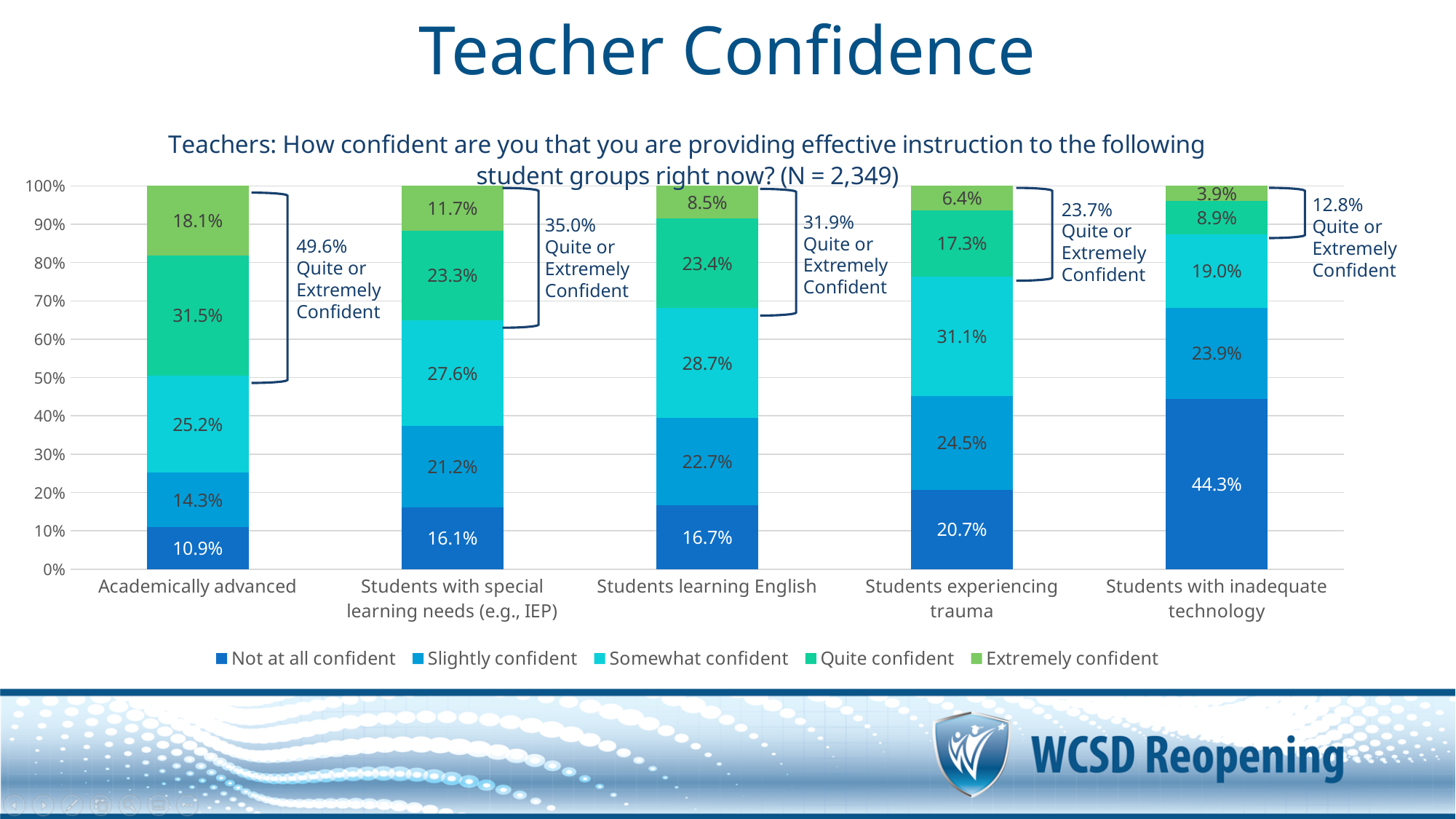
How many series does the legend list? 5 Which student group has the highest 'Not at all confident' percentage? Students with inadequate technology How many student groups are shown on the x axis? 5 What is the difference between the 'Not at all confident' percentages for students with inadequate technology and academically advanced students? 33.4% What percentage of teachers were 'Quite confident' about providing effective instruction to students experiencing trauma? 17.3% Which student group has the lowest 'Extremely confident' percentage? Students with inadequate technology What percentage of teachers were 'Extremely confident' about providing effective instruction to academically advanced students? 18.1% According to the annotation, what percentage of teachers were Quite or Extremely Confident about students learning English? 31.9% Which is larger: the 'Slightly confident' percentage for students experiencing trauma or for students with special learning needs (e.g., IEP)? Students experiencing trauma What kind of chart is shown on the slide? Stacked bar chart What percentage of teachers were 'Not at all confident' about providing effective instruction to students with inadequate technology? 44.3% What percentage of teachers were 'Somewhat confident' about providing effective instruction to students learning English? 28.7%